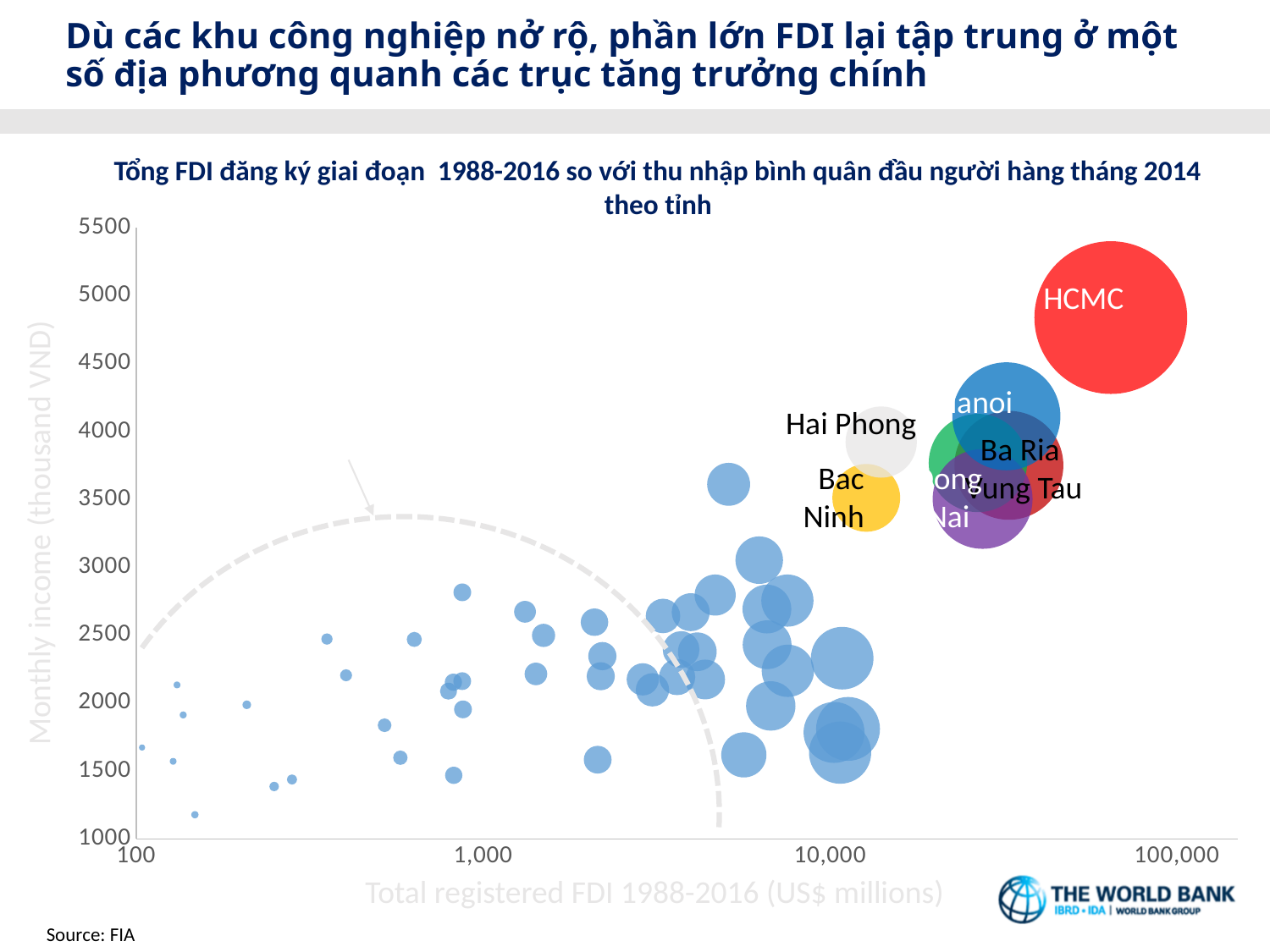
Which has the higher total registered FDI, HCMC or Bac Ninh? HCMC Is the monthly income for Bac Ninh greater or less than 4000? less Is the monthly income for Hai Phong greater or less than 3500? greater Which labelled province has the highest monthly income on the chart? HCMC Is the total registered FDI for Bac Ninh greater or less than 1,000? greater What is the label of the horizontal axis? Total registered FDI 1988-2016 (US$ millions) Which has the higher monthly income, HCMC or Hai Phong? HCMC What is the title of the chart? Tổng FDI đăng ký giai đoạn 1988-2016 so với thu nhập bình quân đầu người hàng tháng 2014 theo tỉnh Which labelled province has the largest bubble on the chart? HCMC What kind of chart is shown on the slide? Bubble chart